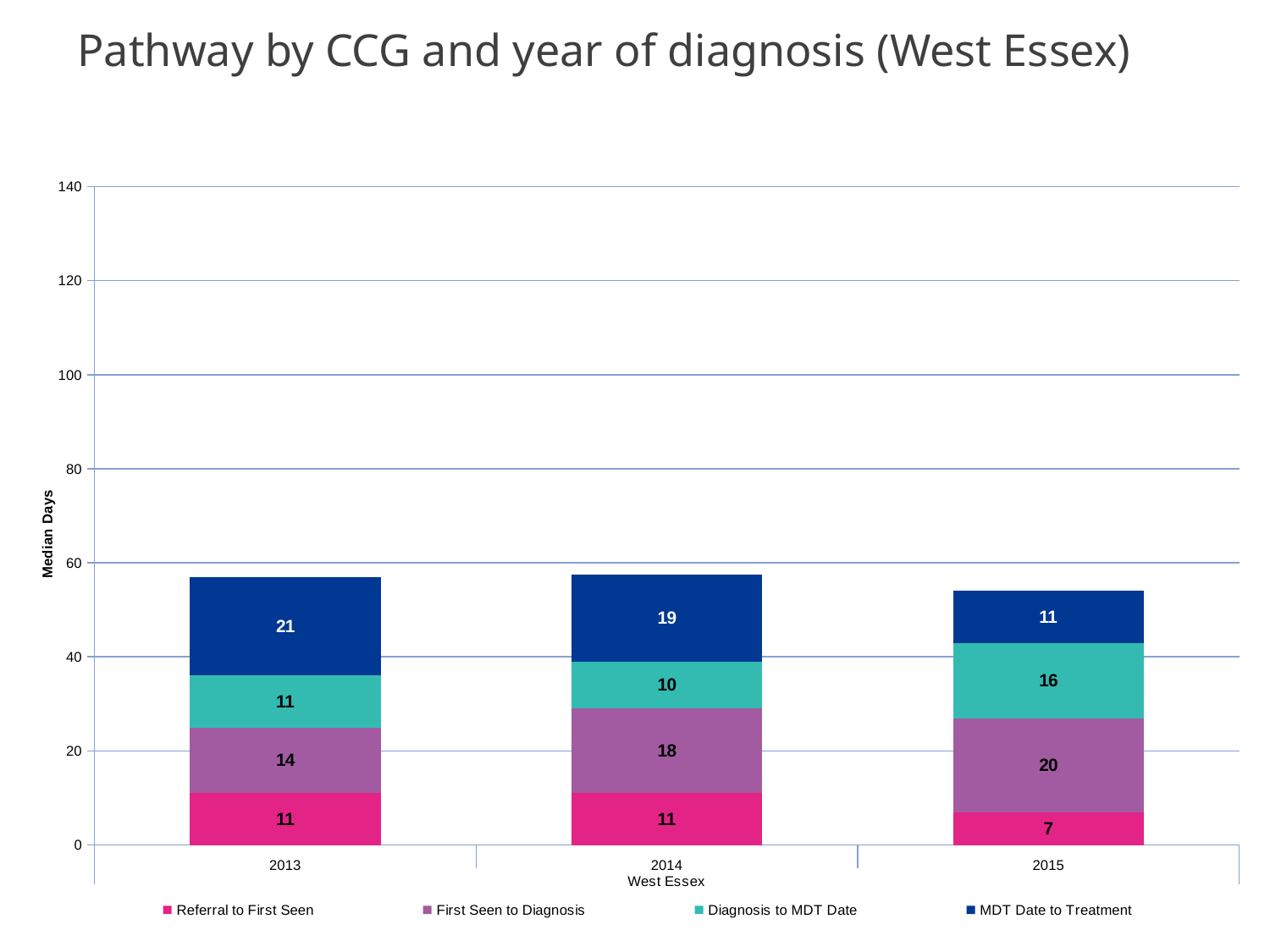
What is the difference between the MDT Date to Treatment values for 2013 and 2015? 10 How many years are shown on the x axis? 3 How many series does the legend list? 4 What is the total median days for the 2014 stacked bar? 58 What is the median days value for MDT Date to Treatment in 2013? 21 What is the median days value for Referral to First Seen in 2015? 7 What kind of chart is shown on the slide? Stacked bar chart Which year has the highest value for MDT Date to Treatment? 2013 What is the total median days for the 2015 stacked bar? 54 Is the total for the 2013 bar greater or less than 60? less What is the median days value for Diagnosis to MDT Date in 2014? 10 What is the median days value for First Seen to Diagnosis in 2015? 20